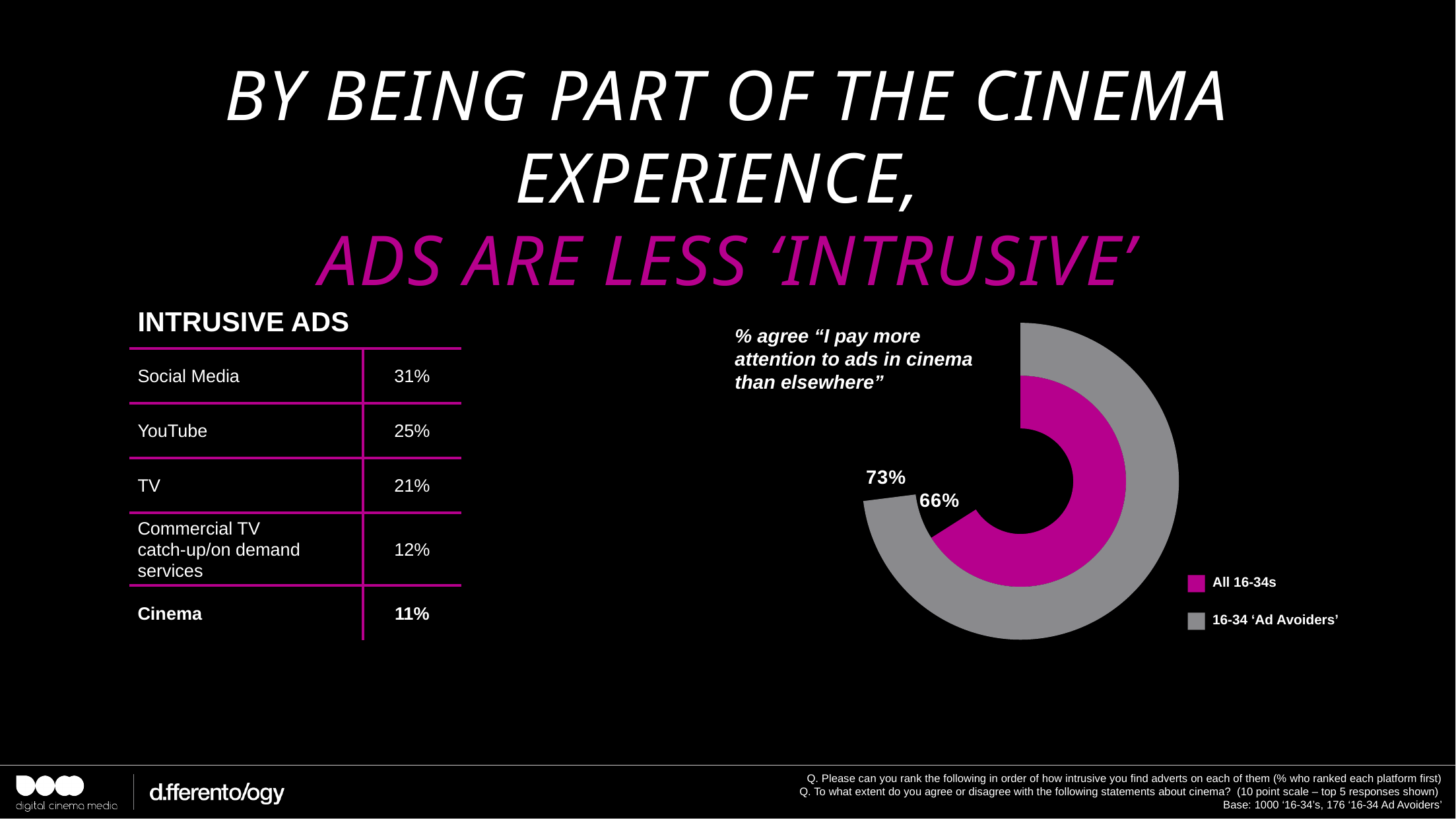
In the doughnut chart, which group has the higher percentage agreeing? 16-34 'Ad Avoiders' In the doughnut chart, what percentage of 16-34 'Ad Avoiders' agree "I pay more attention to ads in cinema than elsewhere"? 73% In the doughnut chart, which colour represents All 16-34s? magenta In the doughnut chart, which group has the lower percentage agreeing? All 16-34s How many data values are plotted in the doughnut chart? 2 In the doughnut chart, what is the difference in percentage points between 16-34 'Ad Avoiders' and All 16-34s? 7 percentage points In the doughnut chart, is the value for All 16-34s larger or smaller than the value for 16-34 'Ad Avoiders'? smaller In the doughnut chart, what percentage of All 16-34s agree "I pay more attention to ads in cinema than elsewhere"? 66% How many groups does the legend of the doughnut chart list? 2 What statement does the doughnut chart measure agreement with? "I pay more attention to ads in cinema than elsewhere" What kind of chart is shown on the right of the slide? doughnut chart